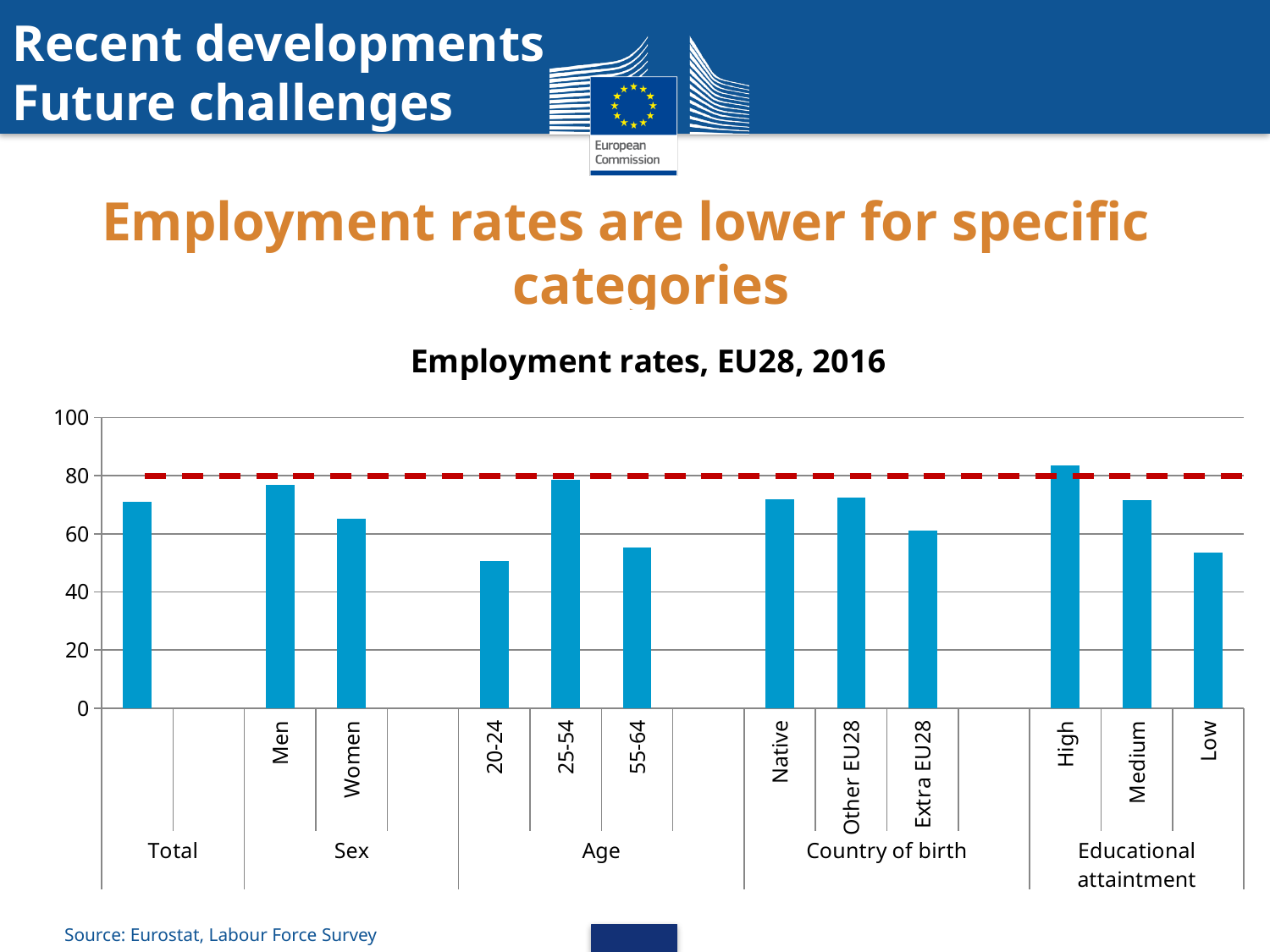
Is the value for 20-24 greater or less than 60? less Which category has the highest employment rate in the chart? High How many category groups are shown along the x axis of the chart? 5 How many bars are plotted in the chart? 12 What is the title of the chart? Employment rates, EU28, 2016 Is the value for Women greater or less than 60? greater At what level on the y axis is the red dashed horizontal line drawn? 80 What kind of chart is shown on the slide? bar chart Which has the larger employment rate, Native or Extra EU28? Native Is the value for High greater or less than 80? greater Which has the larger employment rate, 25-54 or 55-64? 25-54 Is the employment rate for Men higher or lower than for Women? higher